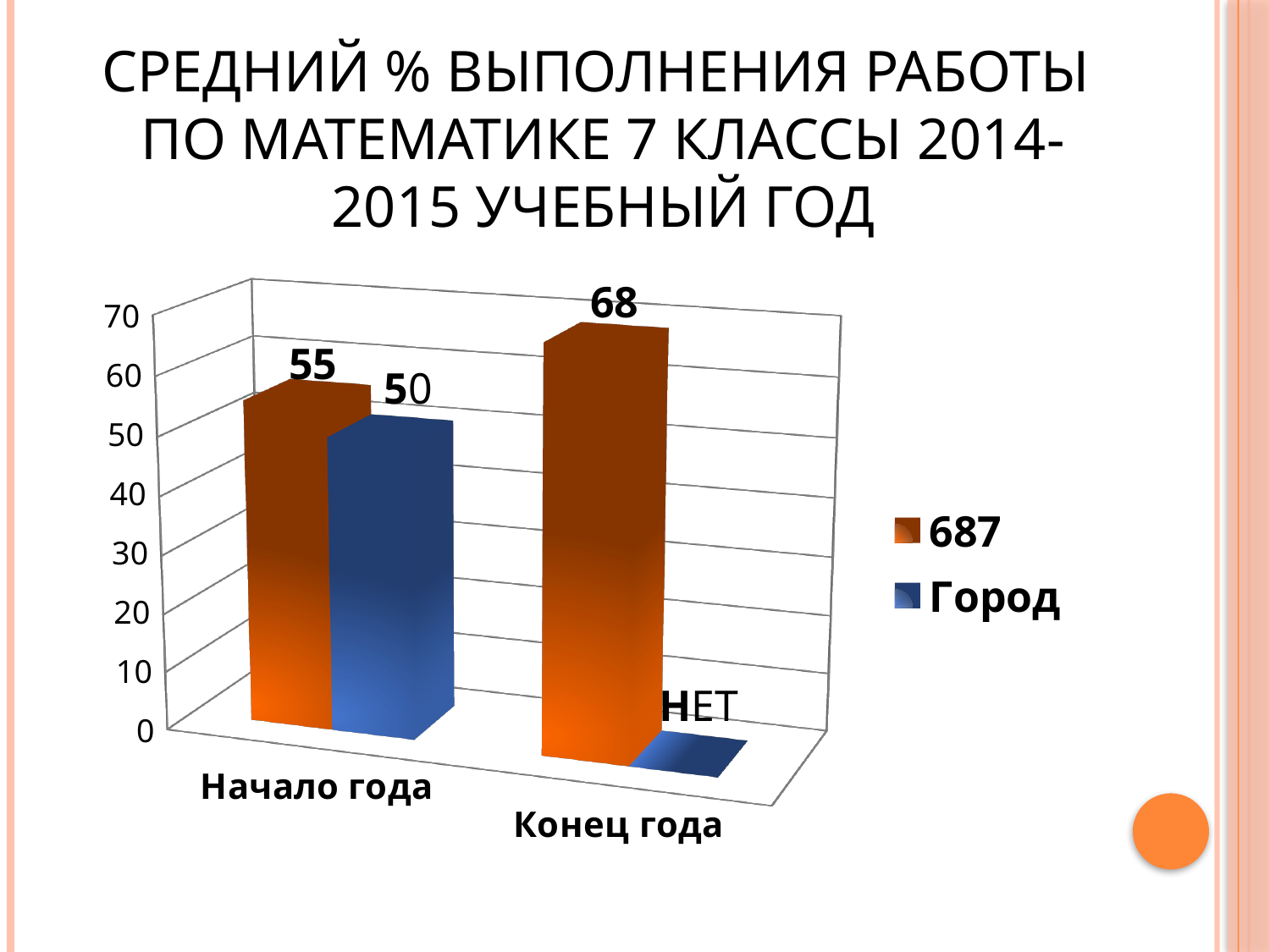
Which category has the highest value for series 687? Конец года What is the difference between the 687 and Город values at Начало года? 5 At Начало года, which series has the larger value, 687 or Город? 687 What is the value for series Город at Начало года? 50 What is the value for series 687 at Начало года? 55 How many series does the legend list? 2 What kind of chart is shown on the slide? bar chart What is the difference between the 687 values at Конец года and Начало года? 13 What label is shown for series Город at Конец года? НЕТ How many categories are shown on the x axis? 2 What is the value for series 687 at Конец года? 68 Does the value for series 687 rise or fall from Начало года to Конец года? rise